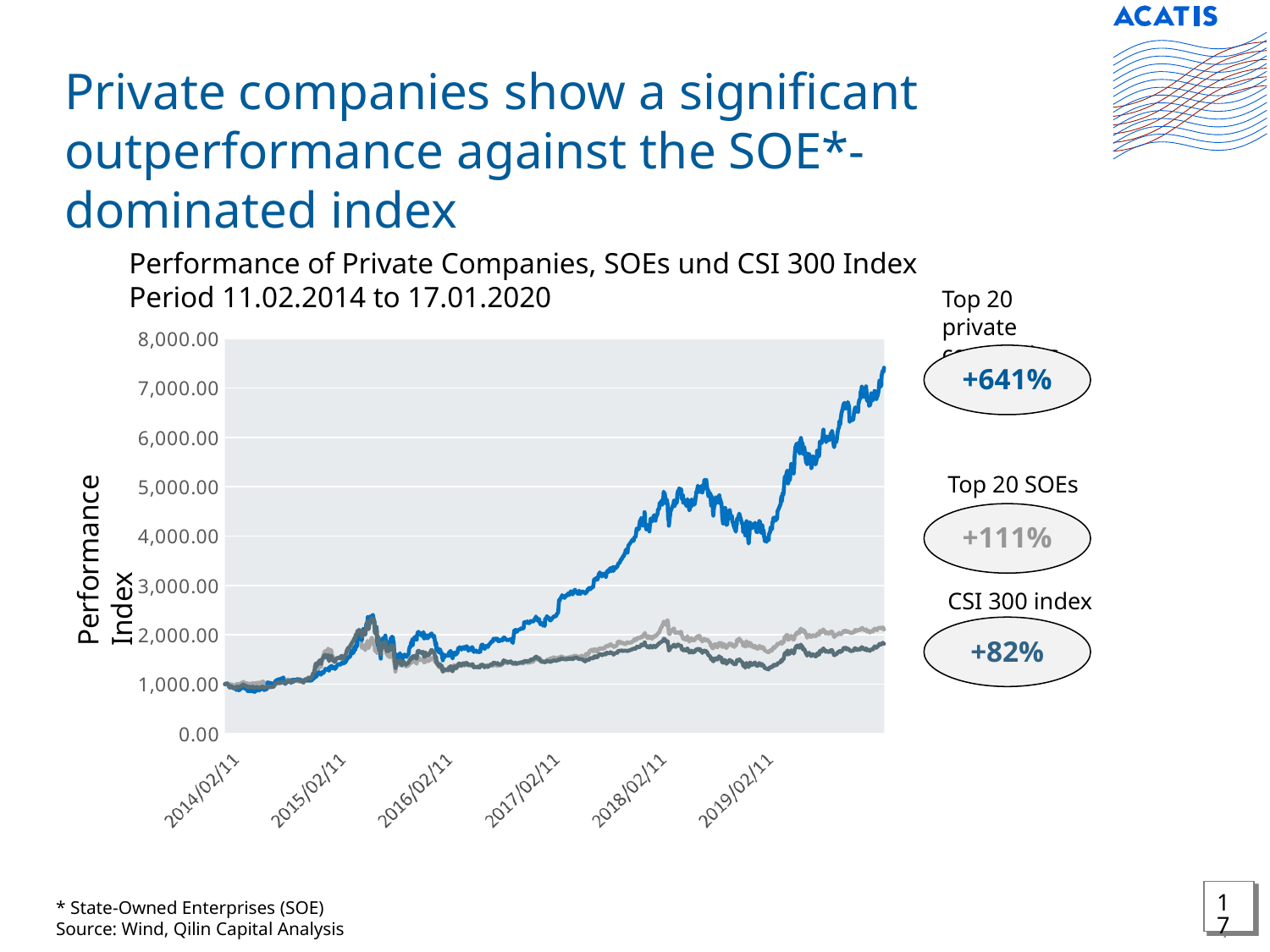
What is the performance gain shown for the Top 20 SOEs? +111% What kind of chart is shown on the slide? line chart What period does the chart cover according to its subtitle? 11.02.2014 to 17.01.2020 What is the performance gain shown for the CSI 300 index? +82% Which group shows the lowest performance gain over the period? CSI 300 index Is the final value of the Top 20 private companies line greater or less than 7,000.00? greater Which has the larger performance gain, the Top 20 SOEs or the CSI 300 index? Top 20 SOEs Does the line for the Top 20 private companies rise or fall overall from 2014 to 2020? rise What is the performance gain shown for the Top 20 private companies? +641% By how many percentage points does the gain of the Top 20 private companies exceed that of the Top 20 SOEs? 530 percentage points How many series are plotted in the chart? 3 Which group shows the highest performance gain over the period? Top 20 private companies